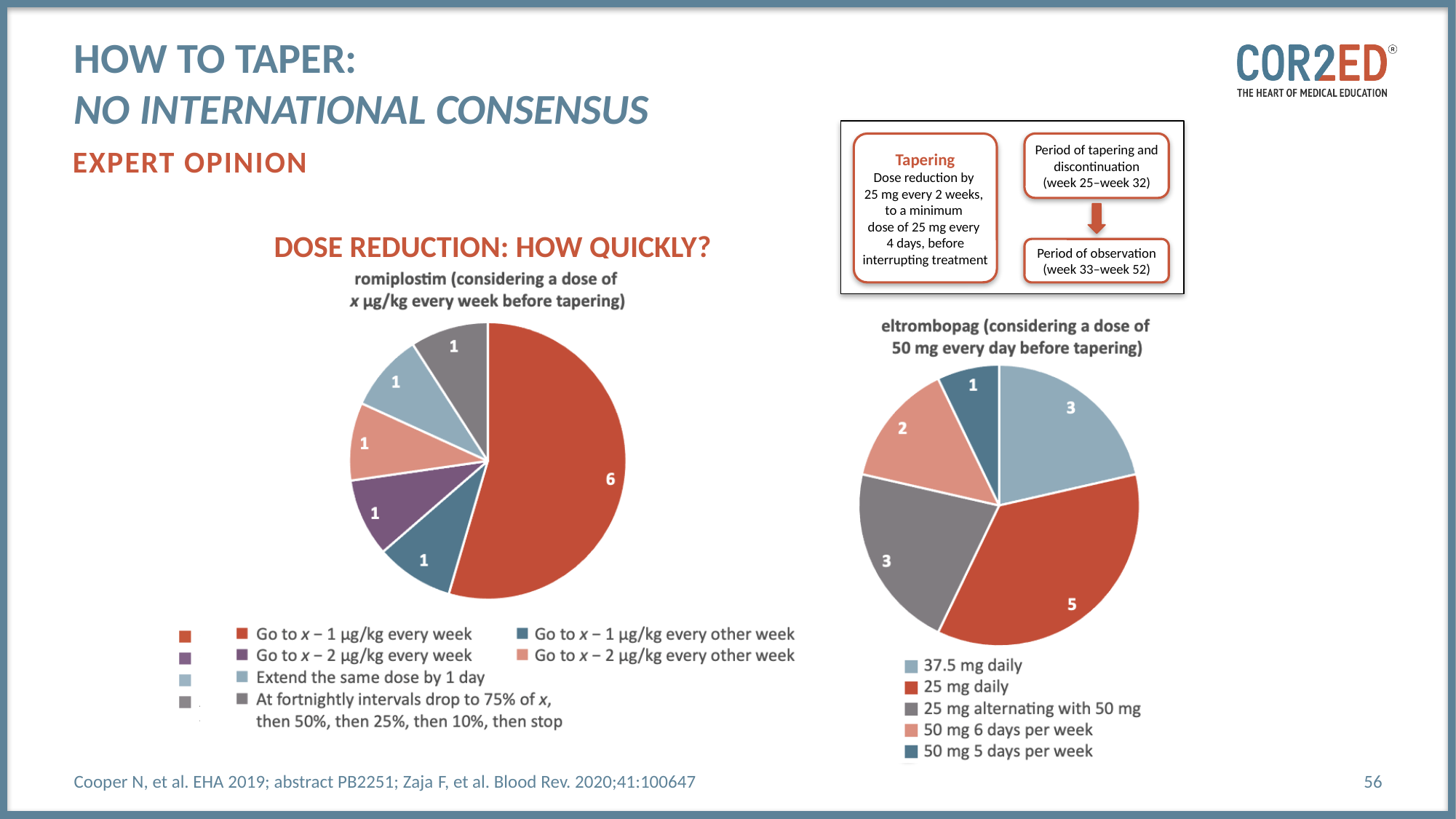
In the eltrombopag pie chart, what is the value for '50 mg 6 days per week'? 2 What is the total of all slice values in the eltrombopag pie chart? 14 In the eltrombopag pie chart, which is larger: '25 mg alternating with 50 mg' or '50 mg 6 days per week'? 25 mg alternating with 50 mg In the eltrombopag pie chart, what is the difference between the values for '25 mg daily' and '37.5 mg daily'? 2 In the eltrombopag pie chart, what is the value for '25 mg daily'? 5 In the eltrombopag pie chart, which option has the smallest slice? 50 mg 5 days per week In the eltrombopag pie chart, which option has the largest slice? 25 mg daily In the romiplostim pie chart, how many respondents chose 'Go to x − 1 µg/kg every week'? 6 How many slices does the eltrombopag pie chart have? 5 What type of chart is used for the eltrombopag data? Pie chart In the romiplostim pie chart, which option has the largest slice? Go to x − 1 µg/kg every week How many slices does the romiplostim pie chart have? 6